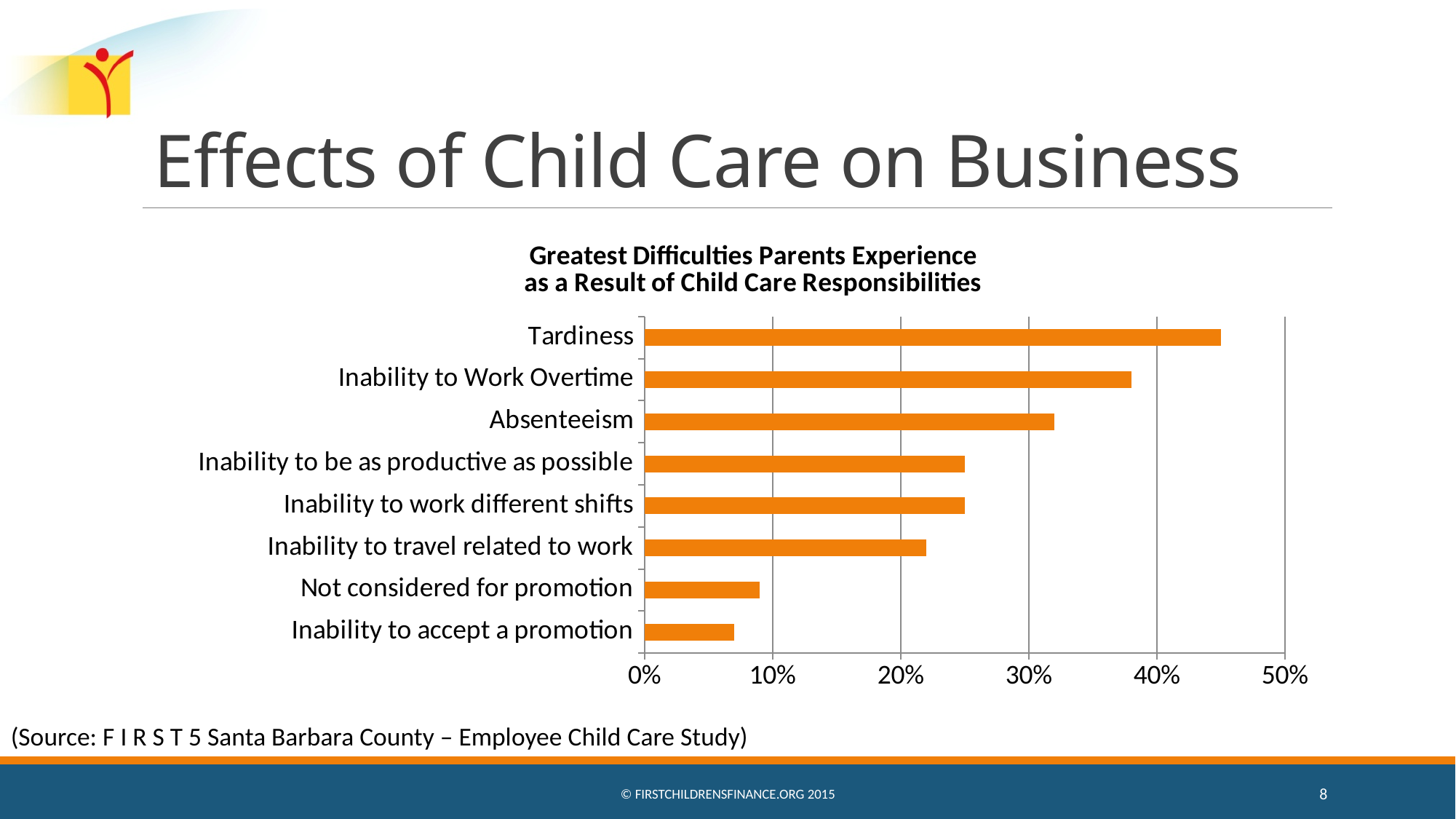
Which is larger, the value for Not considered for promotion or the value for Inability to accept a promotion? Not considered for promotion Is the value for Not considered for promotion greater or less than 10%? less What type of chart is shown on the slide? bar chart Is the value for Inability to be as productive as possible greater or less than 30%? less Which category has the highest value? Tardiness Is the value for Absenteeism greater or less than 40%? less Which is larger, the value for Tardiness or the value for Absenteeism? Tardiness How many categories are plotted in the chart? 8 What is the title of the chart? Greatest Difficulties Parents Experience as a Result of Child Care Responsibilities Which category has the lowest value? Inability to accept a promotion